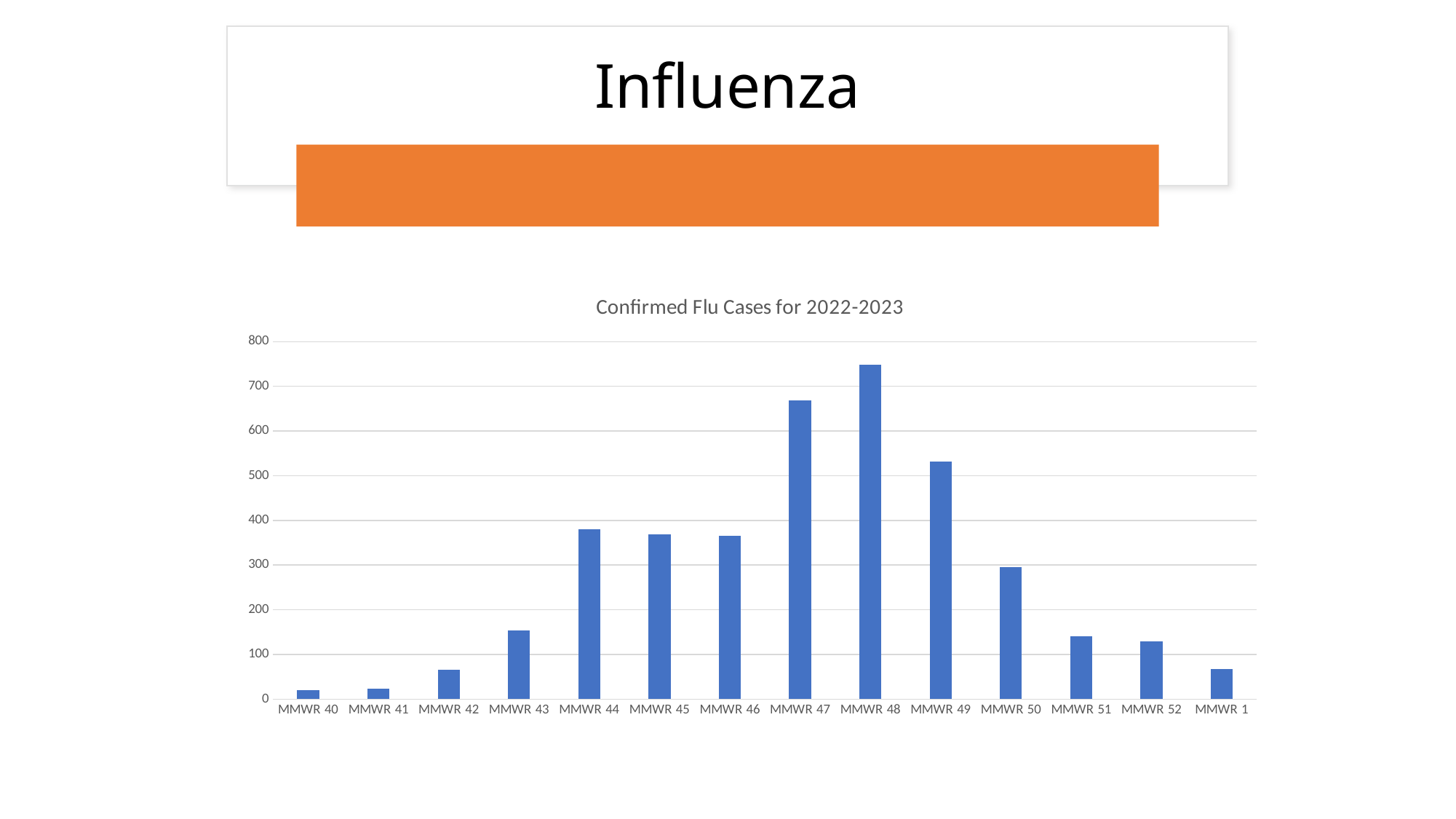
Is the value for MMWR 48 greater or less than 700? greater What kind of chart is shown on the slide? Bar chart Is the value for MMWR 42 greater or less than 100? less Which has more confirmed flu cases, MMWR 47 or MMWR 49? MMWR 47 Which MMWR week has the highest number of confirmed flu cases? MMWR 48 What is the title of the chart? Confirmed Flu Cases for 2022-2023 Which has more confirmed flu cases, MMWR 43 or MMWR 51? MMWR 43 Do the values generally rise or fall from MMWR 48 to MMWR 1? Fall Is the value for MMWR 1 greater or less than 100? less How many MMWR week categories are plotted on the x axis? 14